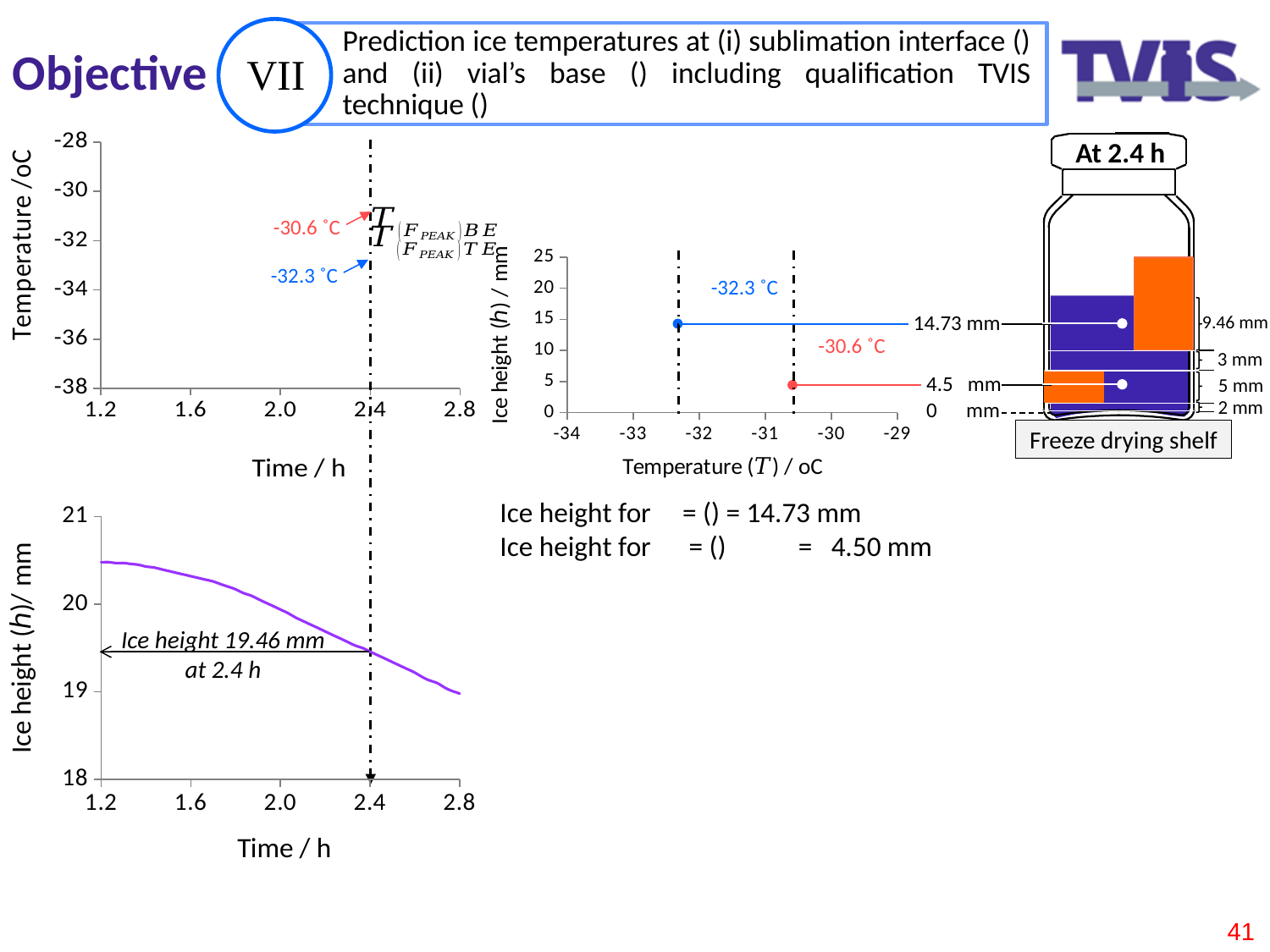
On the bottom-left chart (Ice height vs Time), what ice height is annotated at 2.4 h? 19.46 mm On the bottom-left chart (Ice height vs Time), is the ice height at 2.8 h greater or less than 19.5 mm? less On the bottom-left chart (Ice height vs Time), is the ice height at 1.2 h greater or less than 20 mm? greater On the bottom-left chart (Ice height vs Time), does the ice height rise or fall as time increases from 1.2 h to 2.8 h? fall On the middle chart (Ice height vs Temperature), which point has the larger ice height, the one at -32.3 °C or the one at -30.6 °C? -32.3 °C On the middle chart (Ice height vs Temperature), what is the difference between the ice heights at -32.3 °C and -30.6 °C? 10.23 mm On the top-left chart (Temperature vs Time), which two temperatures are labelled at 2.4 h? -30.6 °C and -32.3 °C On the middle chart (Ice height vs Temperature), what ice height is labelled for the point at -32.3 °C? 14.73 mm What is the x-axis label of the top-left chart? Time / h What kind of chart is the bottom-left chart (Ice height vs Time)? line chart On the middle chart (Ice height vs Temperature), what ice height is labelled for the point at -30.6 °C? 4.5 mm How many data points are plotted on the middle chart (Ice height vs Temperature)? 2